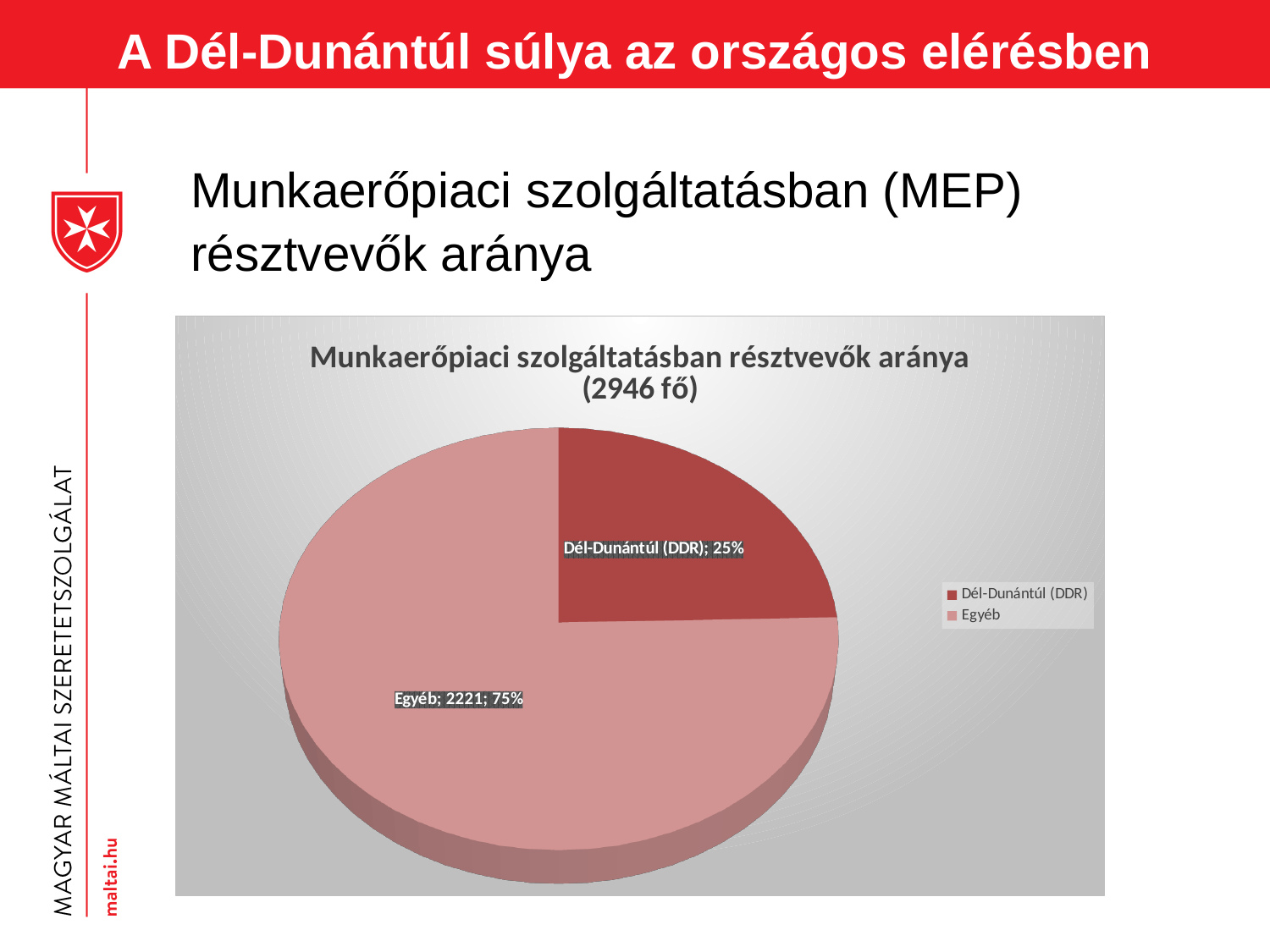
What total number of people is given in the chart title? 2946 fő What is the title of the chart? Munkaerőpiaci szolgáltatásban résztvevők aránya (2946 fő) What share of the pie does the Egyéb slice represent? 75% By how many percentage points does the Egyéb share exceed the Dél-Dunántúl (DDR) share? 50 percentage points How many slices does the pie chart have? 2 What share of the pie does the Dél-Dunántúl (DDR) slice represent? 25% Which is larger, the Dél-Dunántúl (DDR) slice or the Egyéb slice? Egyéb What kind of chart is shown on the slide? pie chart Which slice of the pie is the smallest? Dél-Dunántúl (DDR) How many entries does the legend list? 2 Which slice of the pie is the largest? Egyéb How many people are in the Egyéb category according to the data label? 2221